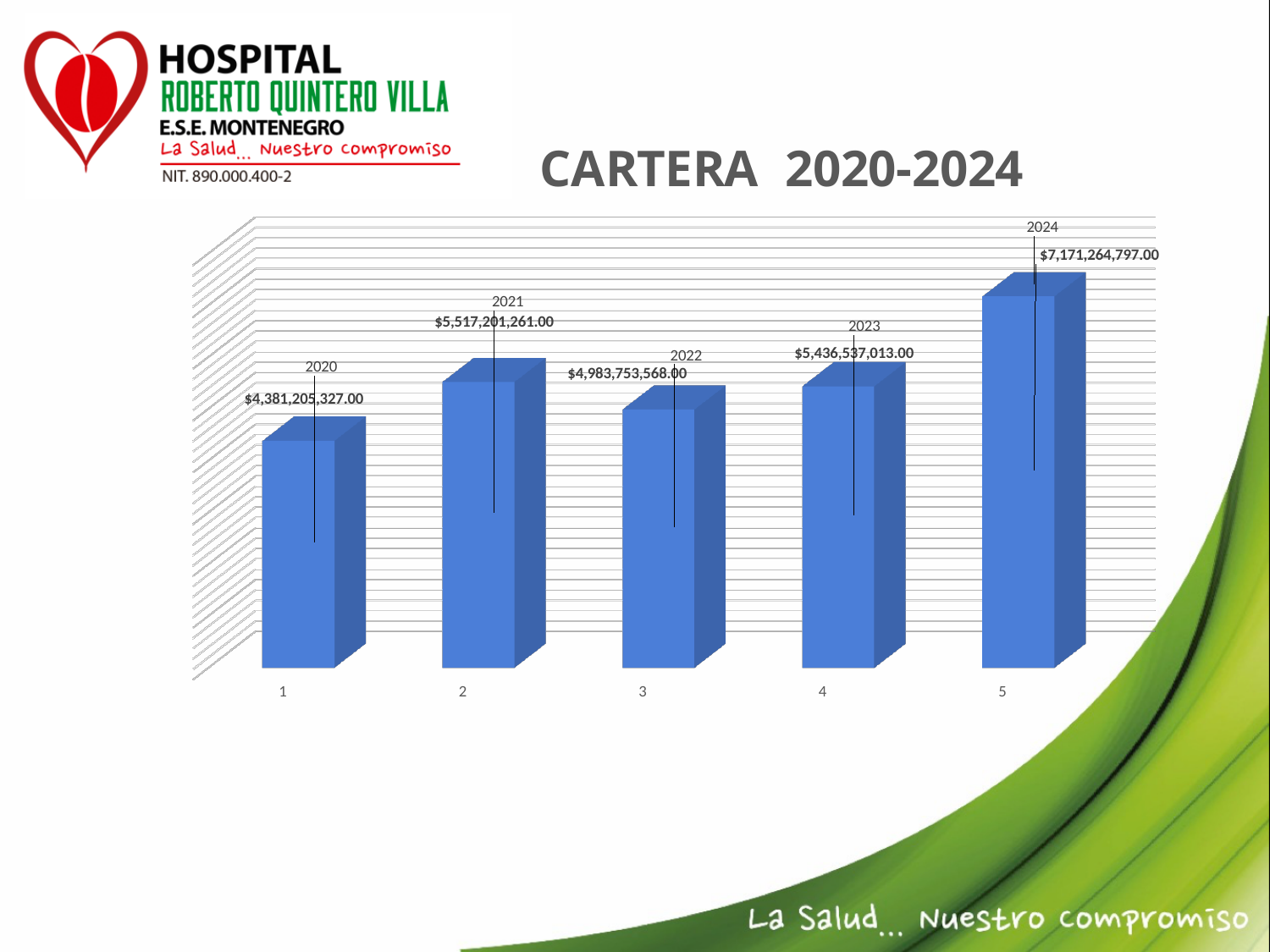
Which year has the lowest value? 2020 Which year has the highest value? 2024 What is the value shown for 2024? $7,171,264,797.00 What is the value shown for 2022? $4,983,753,568.00 Which is larger, the value for 2022 or the value for 2023? 2023 What is the value shown for 2020? $4,381,205,327.00 What is the difference between the values for 2021 and 2022? $533,447,693.00 What type of chart is shown on the slide? Bar chart How many bars are plotted in the chart? 5 What is the value shown for 2021? $5,517,201,261.00 What is the difference between the values for 2024 and 2020? $2,790,059,470.00 What is the value shown for 2023? $5,436,537,013.00